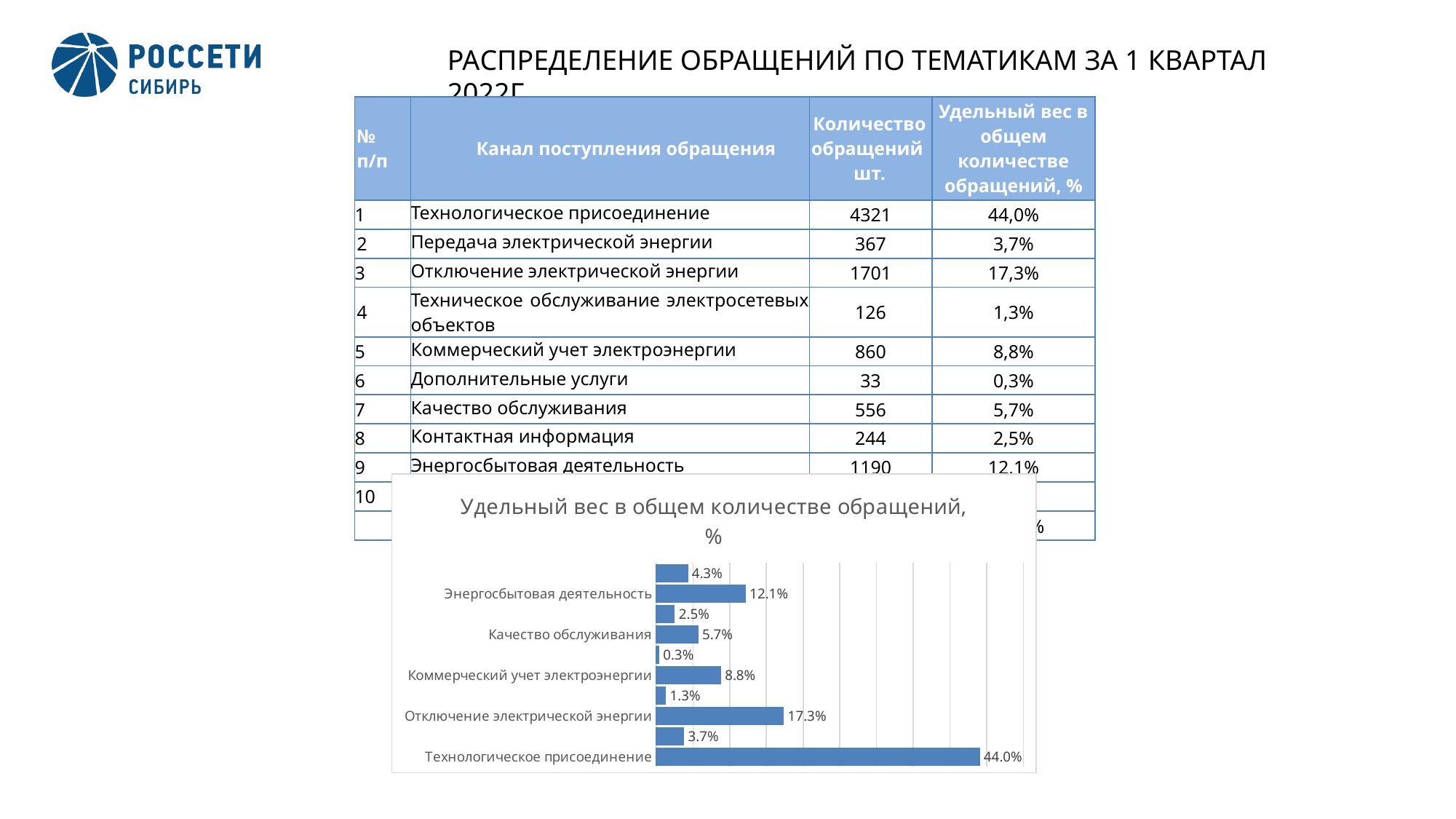
What is the value for Коммерческий учет электроэнергии in the chart? 8.8% What kind of chart is shown on the slide? bar chart What is the value for Энергосбытовая деятельность in the chart? 12.1% What is the value for Отключение электрической энергии in the chart? 17.3% Which is larger in the chart: Качество обслуживания or Коммерческий учет электроэнергии? Коммерческий учет электроэнергии Which category has the highest value in the chart? Технологическое присоединение What is the value for Качество обслуживания in the chart? 5.7% What is the difference between the values for Отключение электрической энергии and Энергосбытовая деятельность in the chart? 5.2% What is the smallest value labelled on any bar in the chart? 0.3% How many bars are plotted in the chart? 10 What is the value for Технологическое присоединение in the chart? 44.0% What is the title of the chart? Удельный вес в общем количестве обращений, %